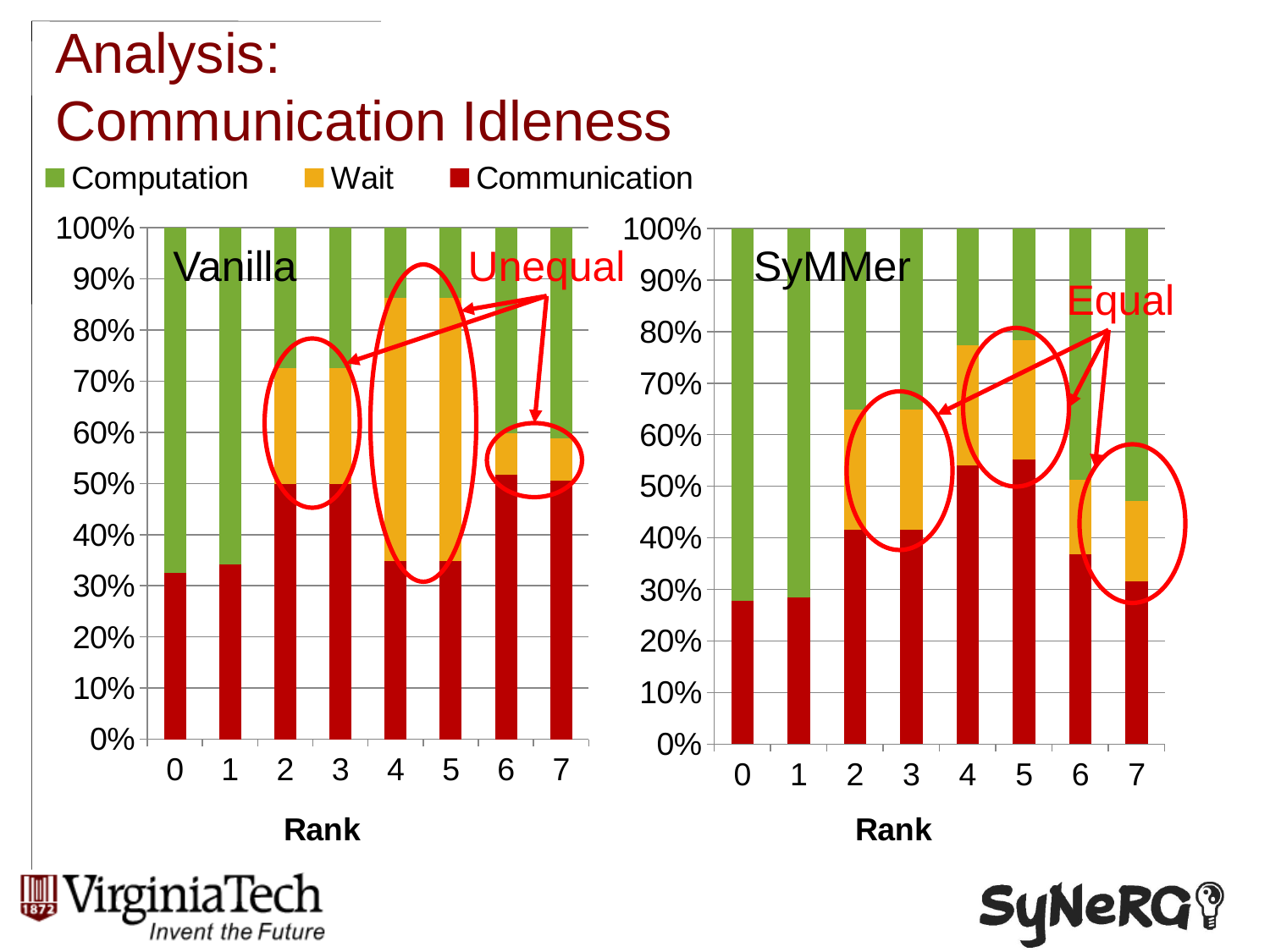
In the Vanilla chart, is the Communication value for rank 0 greater or less than 30%? greater In the Vanilla chart, what is the total of the stacked bar for rank 3? 100% What is the x-axis label of the Vanilla chart? Rank In the SyMMer chart, which has the larger Communication value, rank 5 or rank 7? rank 5 In the SyMMer chart, is the Communication value for rank 0 greater or less than 30%? less How many ranks are plotted on the x axis of the SyMMer chart? 8 How many series does the legend list? 3 In the Vanilla chart, is the Communication value for rank 4 greater or less than 40%? less In the Vanilla chart, which has the larger Communication value, rank 2 or rank 5? rank 2 Which series are listed in the legend? Computation, Wait, Communication What kind of chart is the Vanilla chart on the left? stacked bar chart